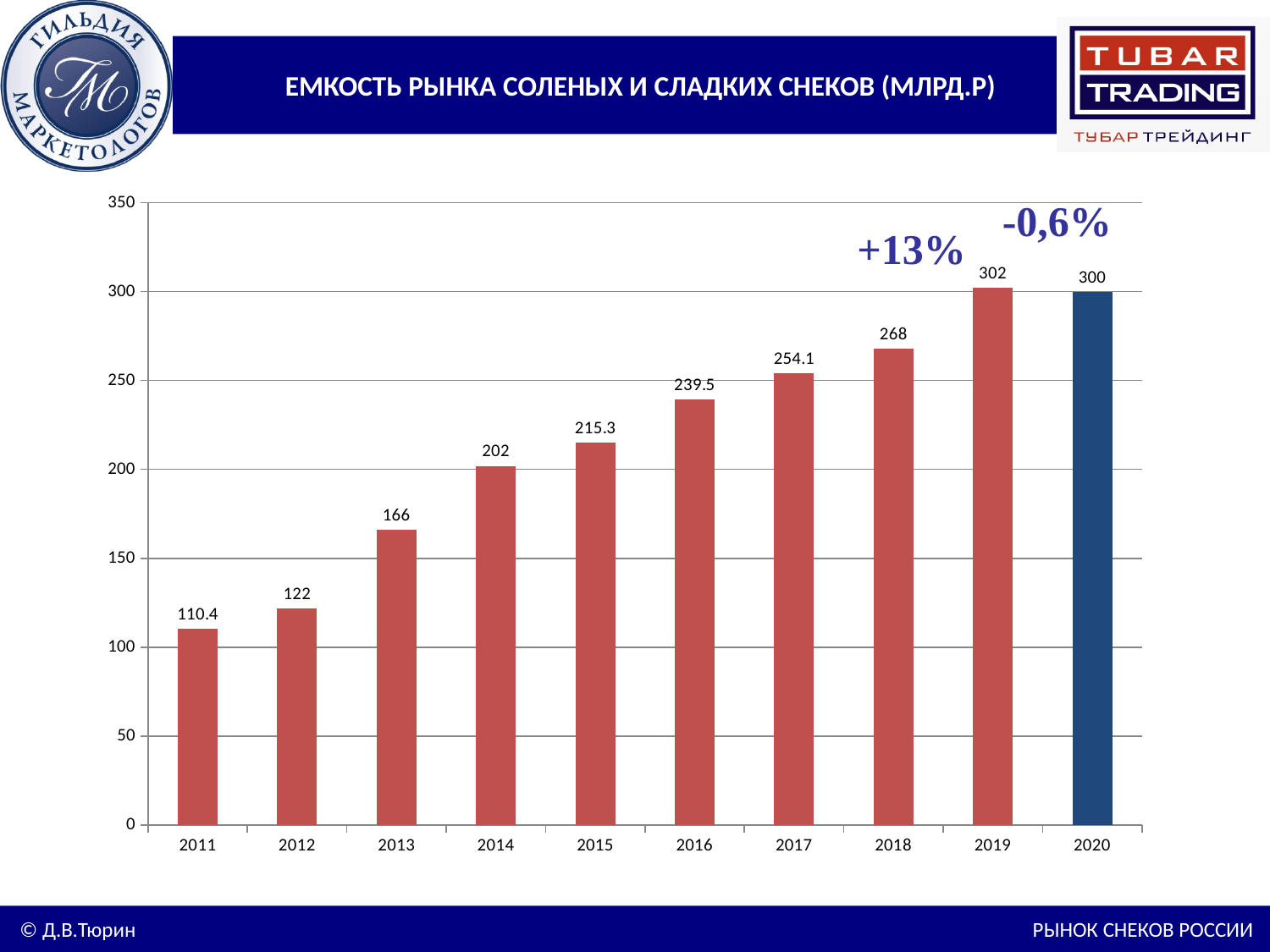
What is the value for 2015? 215.3 Which year has the highest value? 2019 Which is larger, the value for 2017 or the value for 2016? 2017 What is the difference between the values for 2013 and 2012? 44 What kind of chart is shown on the slide? bar chart What is the difference between the values for 2019 and 2018? 34 What is the value for 2020? 300 What is the value for 2011? 110.4 Is the value for 2014 greater or less than 150? greater Which year has the lowest value? 2011 How many years are shown on the x axis? 10 Do the values generally rise or fall from 2011 to 2019? rise